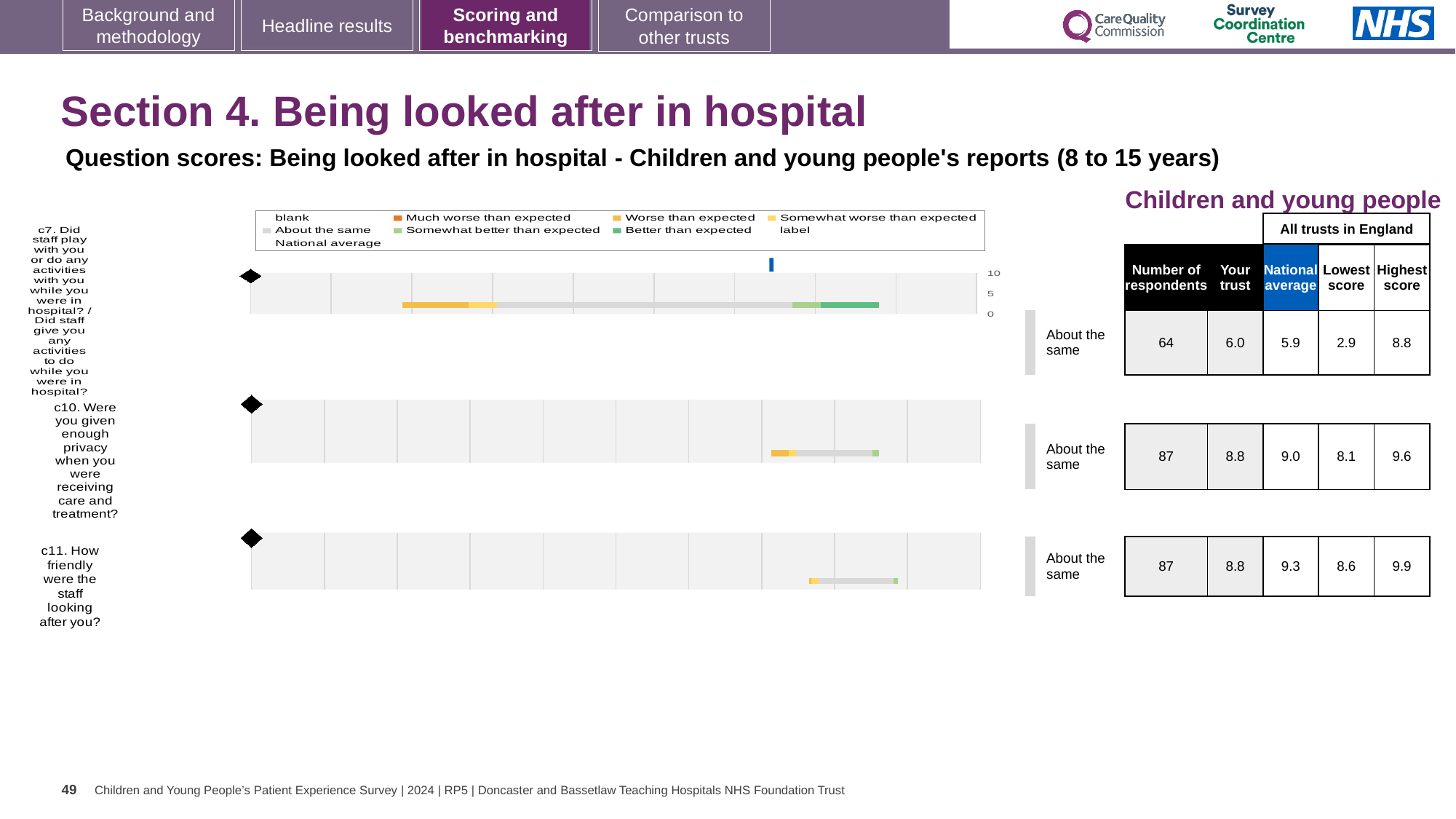
Is the 'Your trust' score for c7 greater or less than 5? greater What is the lowest score across all trusts in England for c10? 8.1 How many respondents answered c7? 64 Which question has the lowest 'Your trust' score? c7 For c10, how much higher is the national average than the 'Your trust' score? 0.2 What is the 'Your trust' score for c10 (Were you given enough privacy when you were receiving care and treatment?)? 8.8 What kind of chart is used to show the question scores on this slide? bar chart What is the highest score across all trusts in England for c11 (How friendly were the staff looking after you?)? 9.9 What is the national average score for c7 (Did staff play with you or do any activities with you while you were in hospital?)? 5.9 For c7, which is larger: the 'Your trust' score or the national average? Your trust How many questions (c7, c10, c11) are charted on this slide? 3 For c11, what is the difference between the highest score and the lowest score across all trusts in England? 1.3